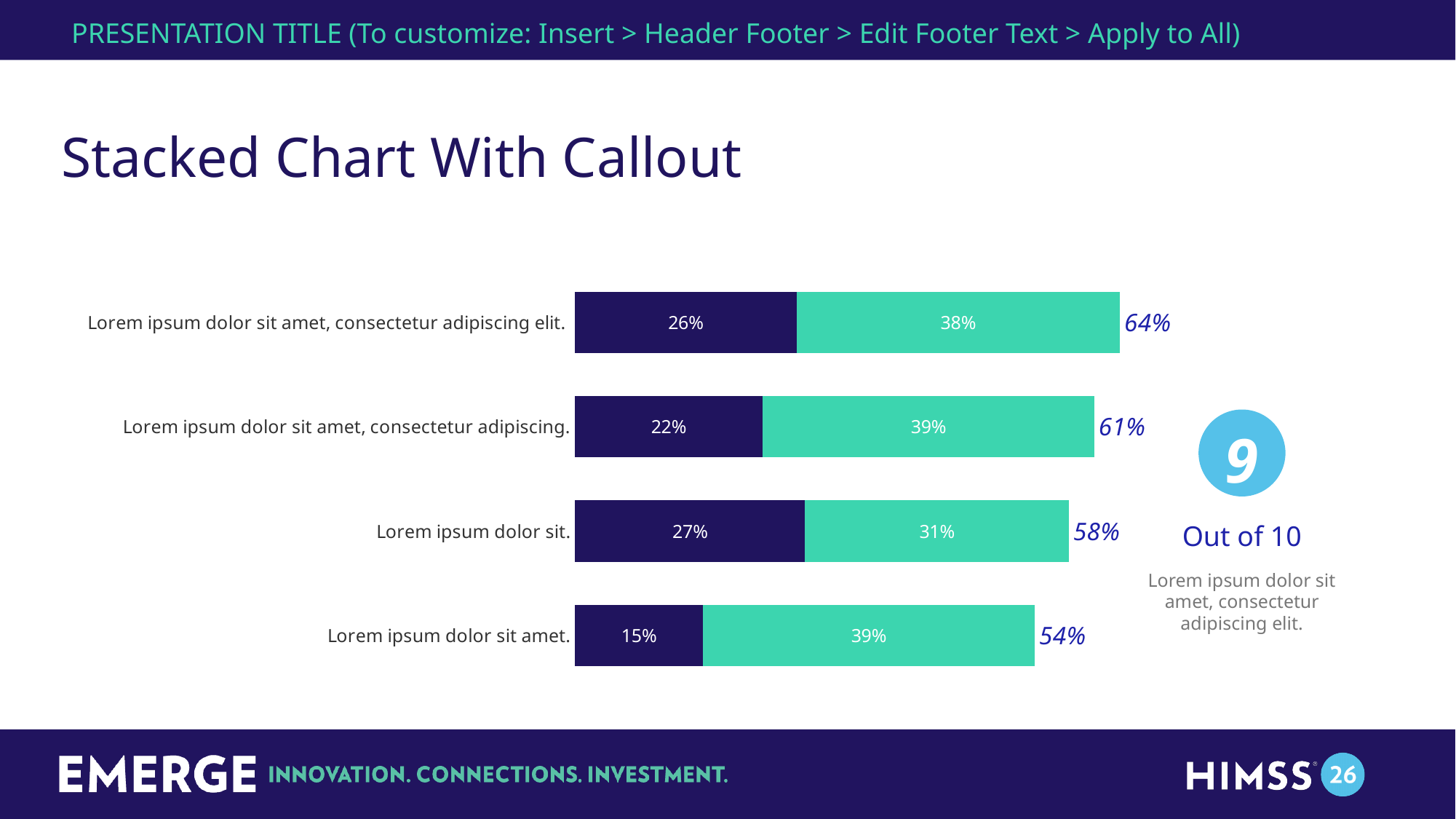
What is the difference between the totals of the top bar (64%) and the bottom bar (54%)? 10% What is the value of the teal segment for the bar labelled "Lorem ipsum dolor sit."? 31% What number is shown in the circular callout to the right of the chart? 9 What is the value of the dark navy segment for the bar labelled "Lorem ipsum dolor sit amet."? 15% What is the total shown for the bar labelled "Lorem ipsum dolor sit amet, consectetur adipiscing elit."? 64% Which bar has the lowest total? Lorem ipsum dolor sit amet. What is the value of the dark navy segment for the bar labelled "Lorem ipsum dolor sit amet, consectetur adipiscing."? 22% Which is larger: the dark navy segment of "Lorem ipsum dolor sit." or the dark navy segment of "Lorem ipsum dolor sit amet."? Lorem ipsum dolor sit. What is the difference between the teal segment (39%) and the dark navy segment (15%) of the bar labelled "Lorem ipsum dolor sit amet."? 24% What kind of chart is shown on the slide? stacked bar chart How many bars (categories) does the chart show? 4 Which bar has the highest total? Lorem ipsum dolor sit amet, consectetur adipiscing elit.